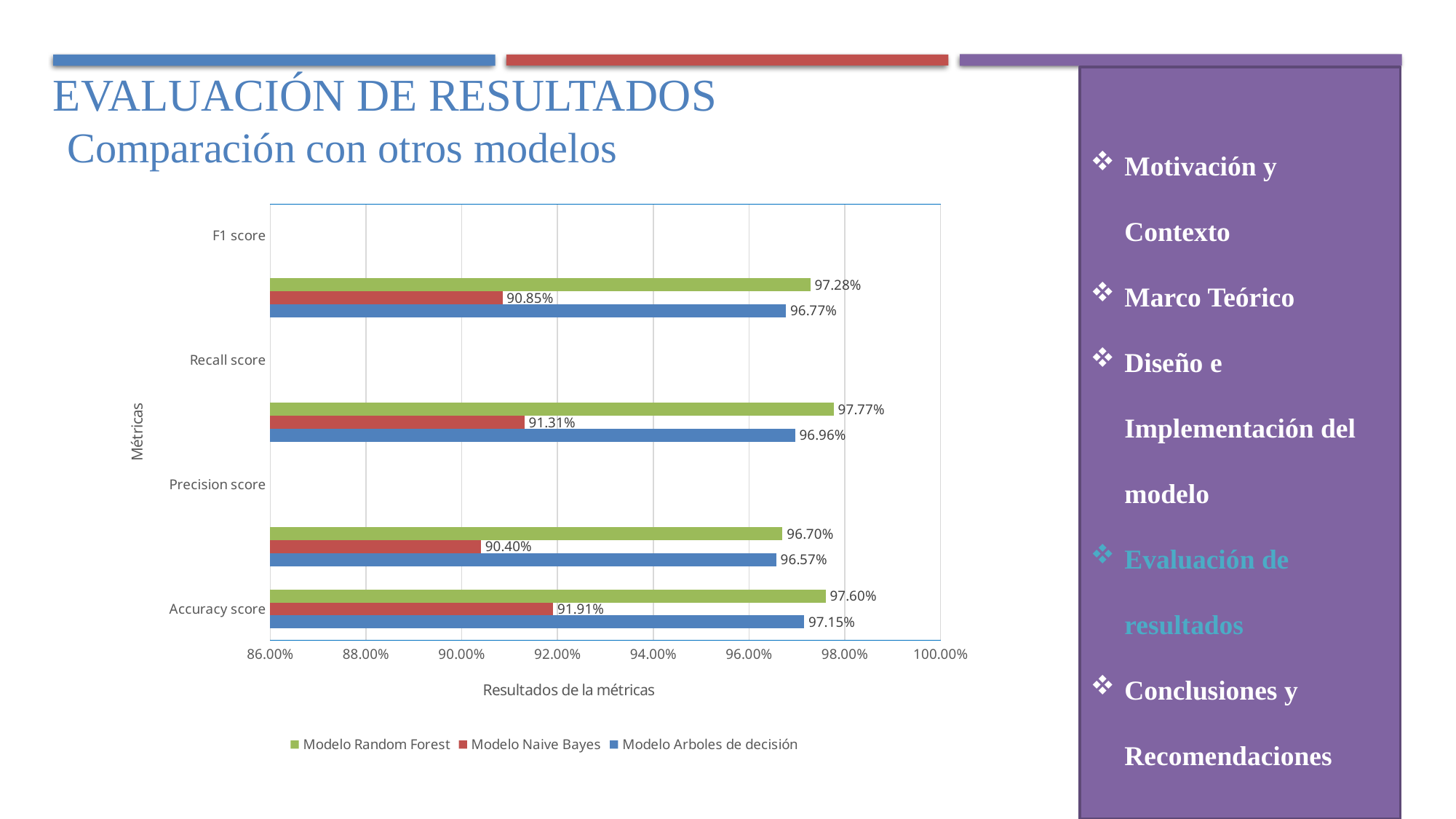
What is the F1 score for Modelo Random Forest? 97.28% How many metrics are shown on the y axis of the chart? 4 What is the Accuracy score for Modelo Naive Bayes? 91.91% How many series does the legend list? 3 Which metric has the highest value for Modelo Random Forest? Recall score What kind of chart is shown on the slide? Bar chart Which model has the lowest Precision score? Modelo Naive Bayes What is the Accuracy score for Modelo Random Forest? 97.60% What is the Recall score for Modelo Arboles de decisión? 96.96% Which is larger, the F1 score of Modelo Random Forest or of Modelo Arboles de decisión? Modelo Random Forest What is the difference between the Accuracy score of Modelo Random Forest and Modelo Naive Bayes? 5.69% What is the label of the x axis of the chart? Resultados de la métricas